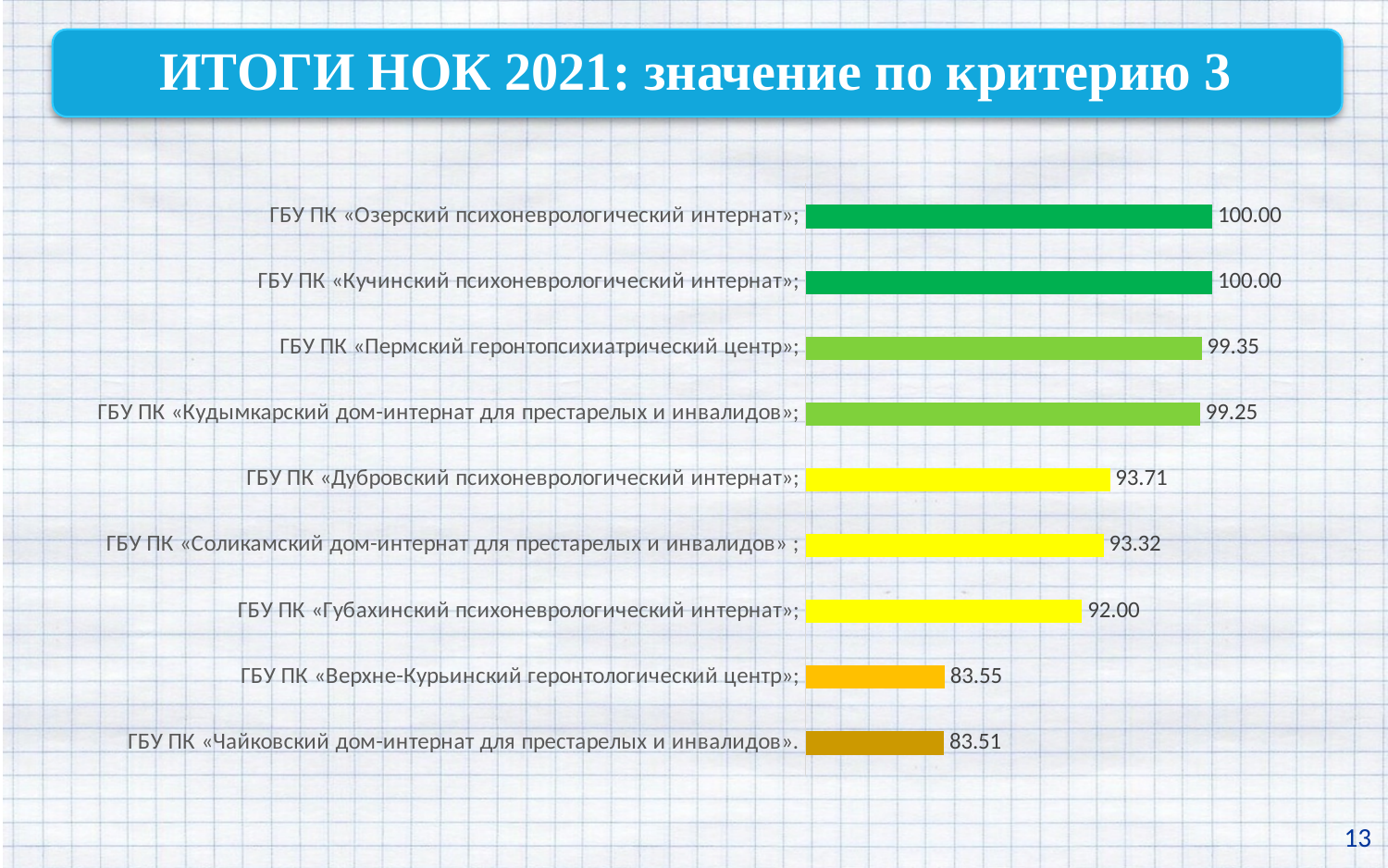
What value is shown for ГБУ ПК «Пермский геронтопсихиатрический центр»? 99.35 What is the difference between the values for ГБУ ПК «Дубровский психоневрологический интернат» and ГБУ ПК «Губахинский психоневрологический интернат»? 1.71 Which has a larger value: ГБУ ПК «Кудымкарский дом-интернат для престарелых и инвалидов» or ГБУ ПК «Дубровский психоневрологический интернат»? ГБУ ПК «Кудымкарский дом-интернат для престарелых и инвалидов» What value is shown for ГБУ ПК «Соликамский дом-интернат для престарелых и инвалидов»? 93.32 How many institutions are shown on the chart? 9 What value is shown for ГБУ ПК «Губахинский психоневрологический интернат»? 92.00 Which institution has the lowest value on the chart? ГБУ ПК «Чайковский дом-интернат для престарелых и инвалидов» What kind of chart is shown on the slide? Bar chart What value is shown for ГБУ ПК «Верхне-Курьинский геронтологический центр»? 83.55 What is the title of the slide? ИТОГИ НОК 2021: значение по критерию 3 Do the values rise or fall going from the top bar to the bottom bar? Fall What is the difference between the value for ГБУ ПК «Озерский психоневрологический интернат» and the value for ГБУ ПК «Чайковский дом-интернат для престарелых и инвалидов»? 16.49